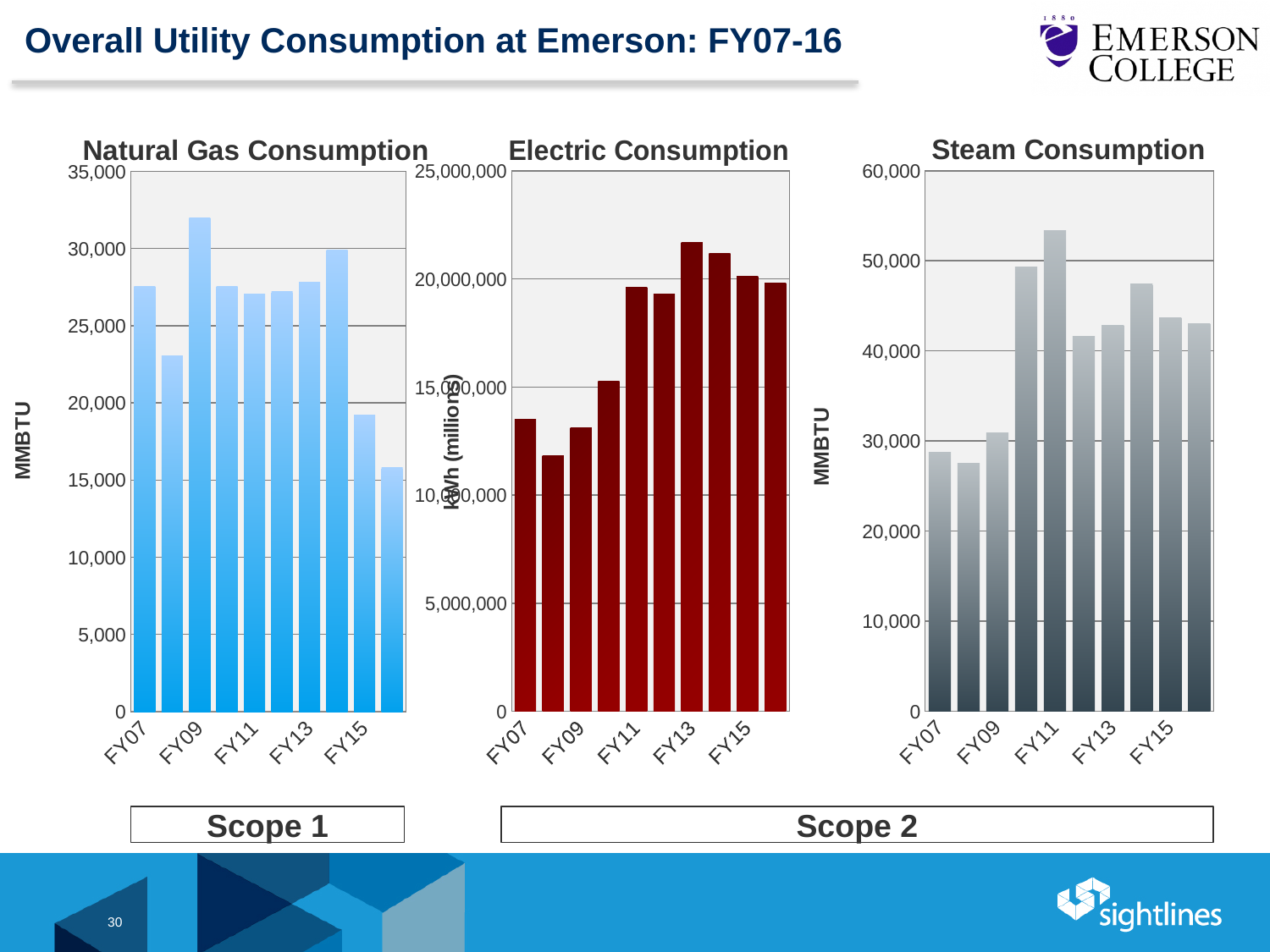
In the Electric Consumption chart, which is larger, the value for FY11 or the value for FY07? FY11 What is the y-axis label of the Electric Consumption chart? kWh (millions) How many bars are plotted in the Electric Consumption chart? 10 In the Steam Consumption chart, which is larger, the value for FY11 or the value for FY09? FY11 What kind of chart is the Steam Consumption chart? bar chart In the Electric Consumption chart, which fiscal year has the highest bar? FY13 In the Natural Gas Consumption chart, is the value for FY09 greater or less than 30,000? greater In the Steam Consumption chart, which fiscal year has the highest bar? FY11 In the Natural Gas Consumption chart, is the value for FY15 greater or less than 20,000? less In the Steam Consumption chart, is the value for FY07 greater or less than 30,000? less In the Natural Gas Consumption chart, which fiscal year has the highest bar? FY09